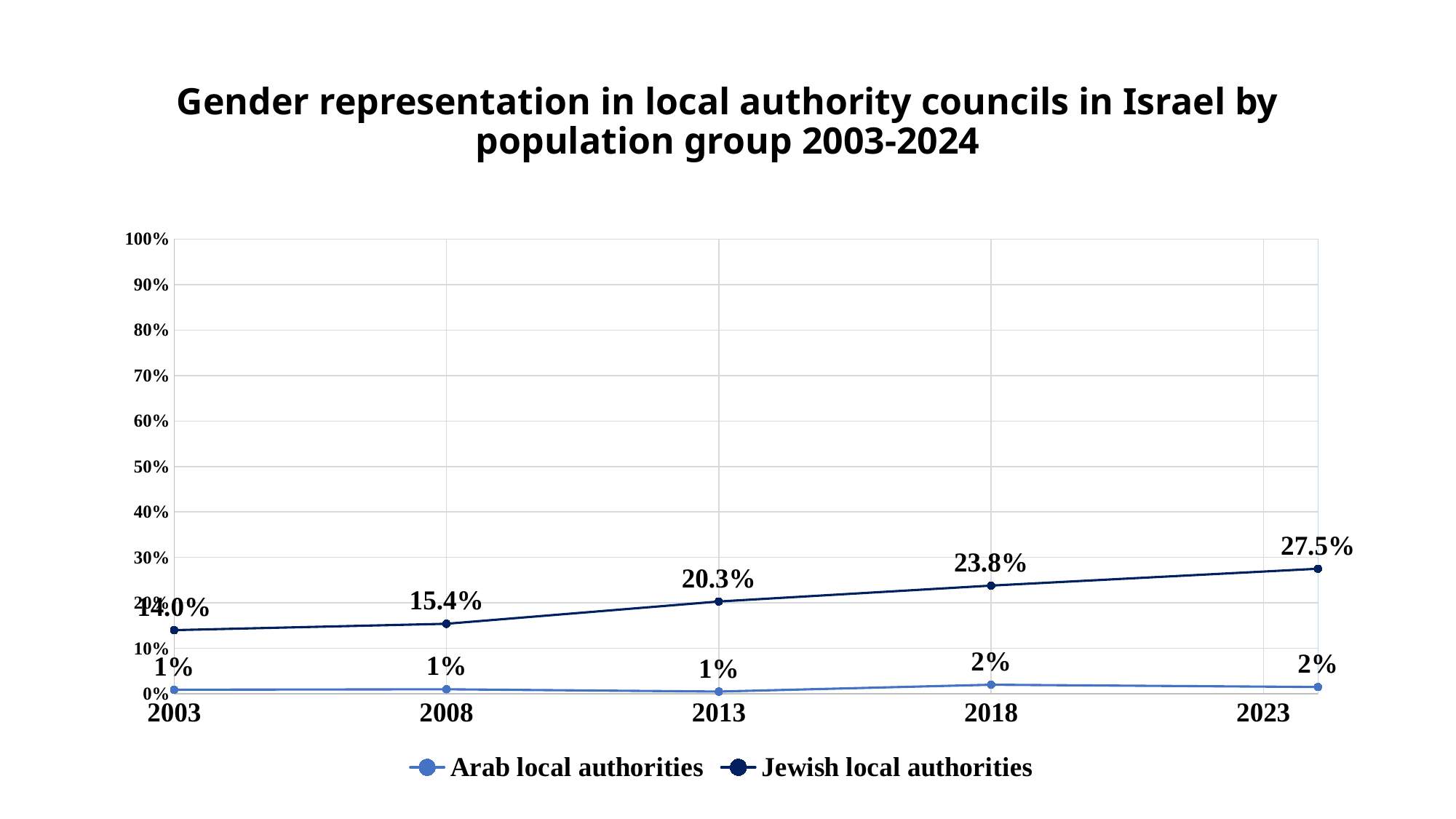
What is the value for Arab local authorities in 2013? 1% What is the value for Jewish local authorities in 2008? 15.4% In 2013, which series has the larger value: Arab local authorities or Jewish local authorities? Jewish local authorities Is the value for Jewish local authorities in 2003 greater or less than 20%? less What is the value for Jewish local authorities at the last data point on the chart? 27.5% What is the value for Jewish local authorities in 2013? 20.3% How many series does the legend list? 2 By how many percentage points did the Jewish local authorities value increase from 2013 to 2018? 3.5 percentage points What is the value for Arab local authorities in 2018? 2% What kind of chart is shown on the slide? line chart What is the value for Jewish local authorities in 2018? 23.8% Do the values for Jewish local authorities rise or fall from 2003 to the last data point? rise